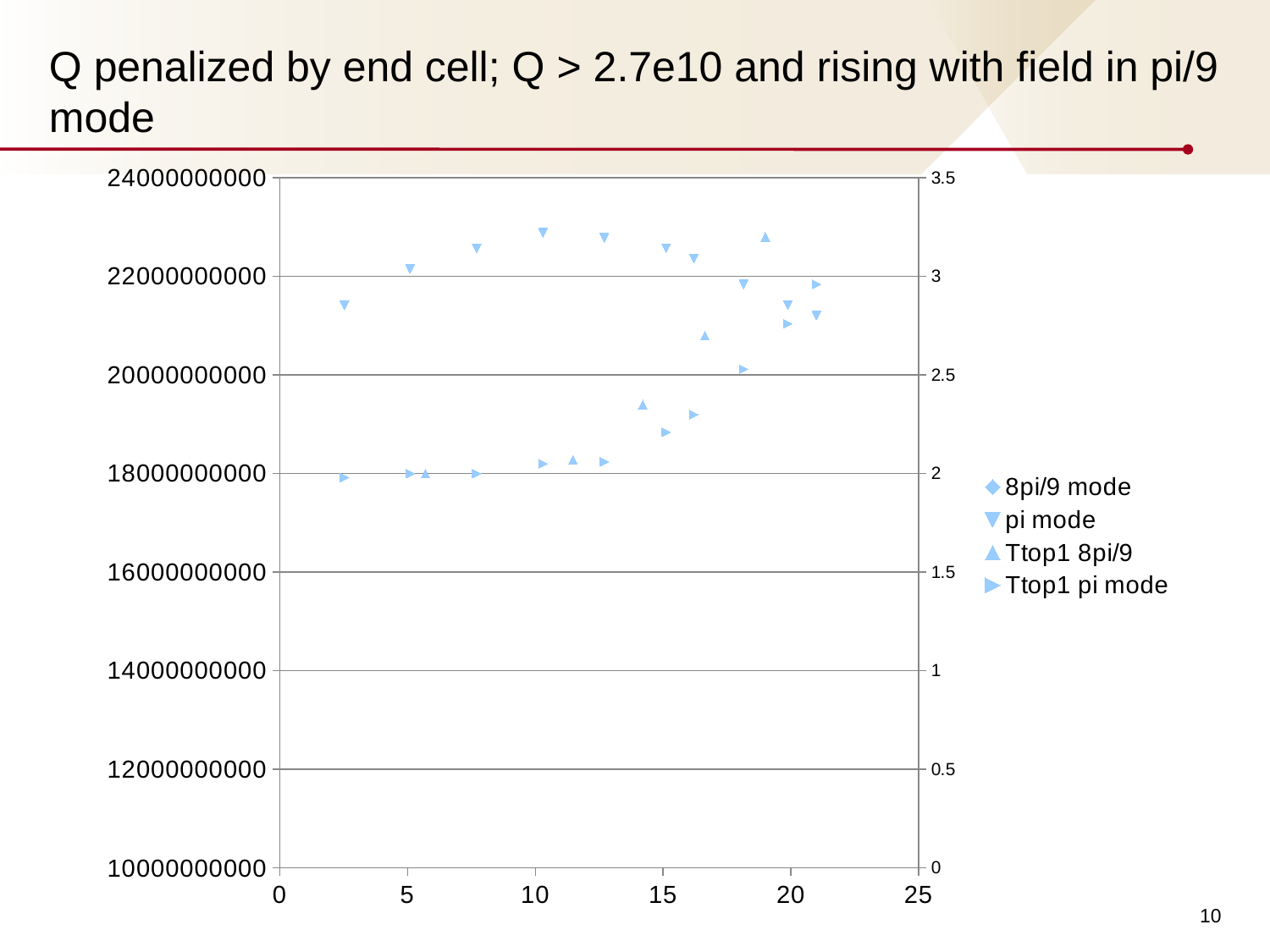
Read against the left axis, is the Ttop1 pi mode point near x = 21 greater or less than 20000000000? greater Read against the left axis, is the pi mode point near x = 2.5 greater or less than 22000000000? less Which series is listed last in the legend? Ttop1 pi mode What is the title of the slide containing the chart? Q penalized by end cell; Q > 2.7e10 and rising with field in pi/9 mode Read against the left axis, is the Ttop1 pi mode point near x = 2.5 greater or less than 20000000000? less Do the Ttop1 8pi/9 values rise or fall as the x value increases? rise How many series does the legend list? 4 Do the Ttop1 pi mode values rise or fall as the x value increases from 0 to 25? rise What kind of chart is shown on the slide? scatter chart